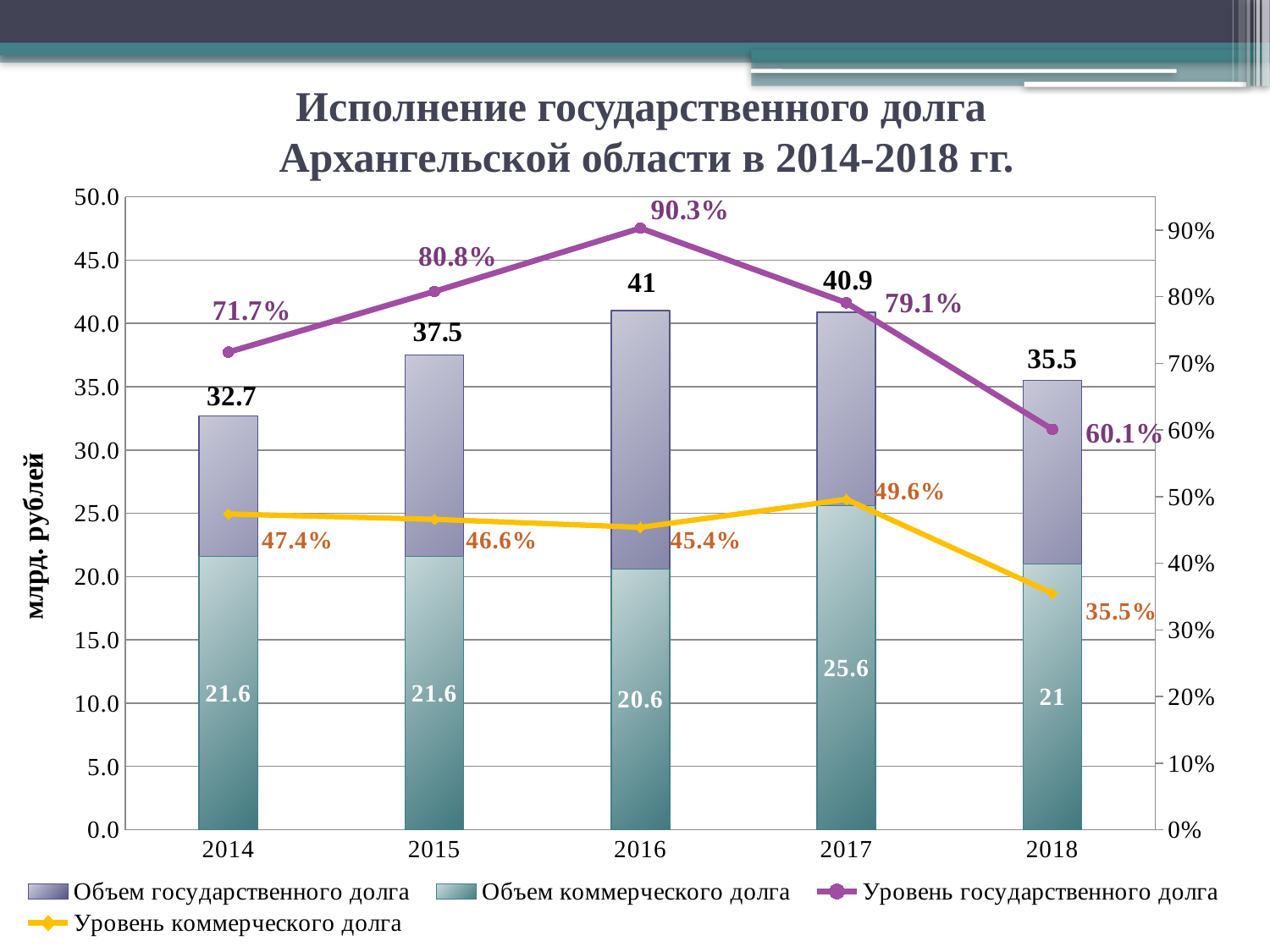
What is the difference between the Объем государственного долга labels for 2016 and 2014? 8.3 What value is labelled for Объем коммерческого долга in 2017? 25.6 How many years are shown on the x axis? 5 What value is labelled for Объем государственного долга in 2016? 41 What is the label of the left vertical axis? млрд. рублей What is the Уровень коммерческого долга value for 2015? 46.6% In which year is Уровень государственного долга highest? 2016 Which is larger, the Объем коммерческого долга label for 2017 or for 2016? 2017 Does Уровень государственного долга rise or fall from 2016 to 2018? fall In which year is Уровень коммерческого долга lowest? 2018 What is the Уровень государственного долга value for 2018? 60.1% How many series does the legend list? 4